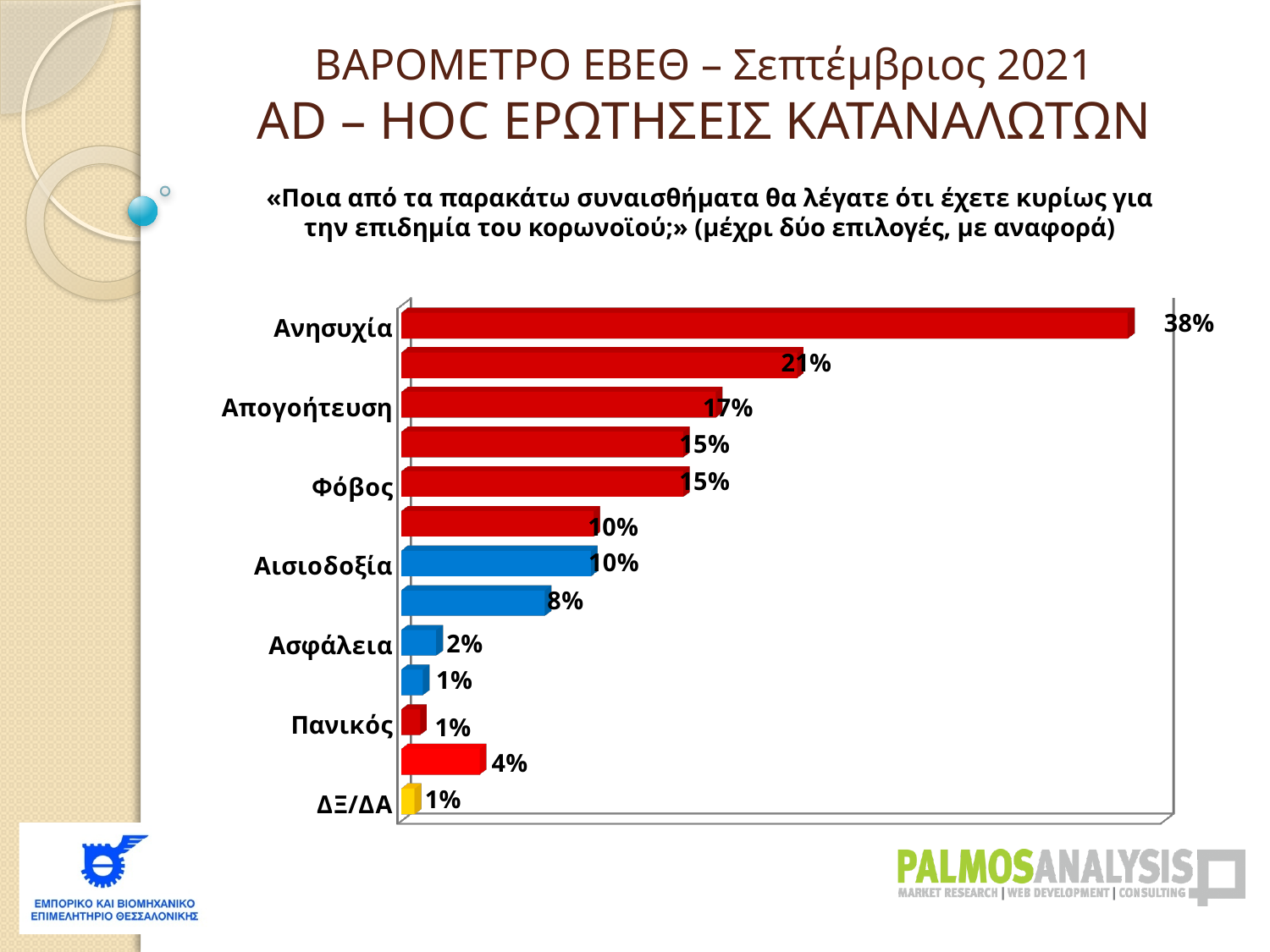
What percentage is shown for Πανικός? 1% What percentage is shown for Φόβος? 15% What percentage is shown for Απογοήτευση? 17% What percentage is shown for ΔΞ/ΔΑ? 1% Which category has the highest value in the chart? Ανησυχία What percentage is shown for Αισιοδοξία? 10% What kind of chart is shown on the slide? Bar chart What percentage is shown for Ανησυχία? 38% What is the difference in percentage points between Ανησυχία and Απογοήτευση? 21 percentage points How many bars are plotted in the chart? 13 What percentage is shown for Ασφάλεια? 2% Which has the larger value, Φόβος or Αισιοδοξία? Φόβος